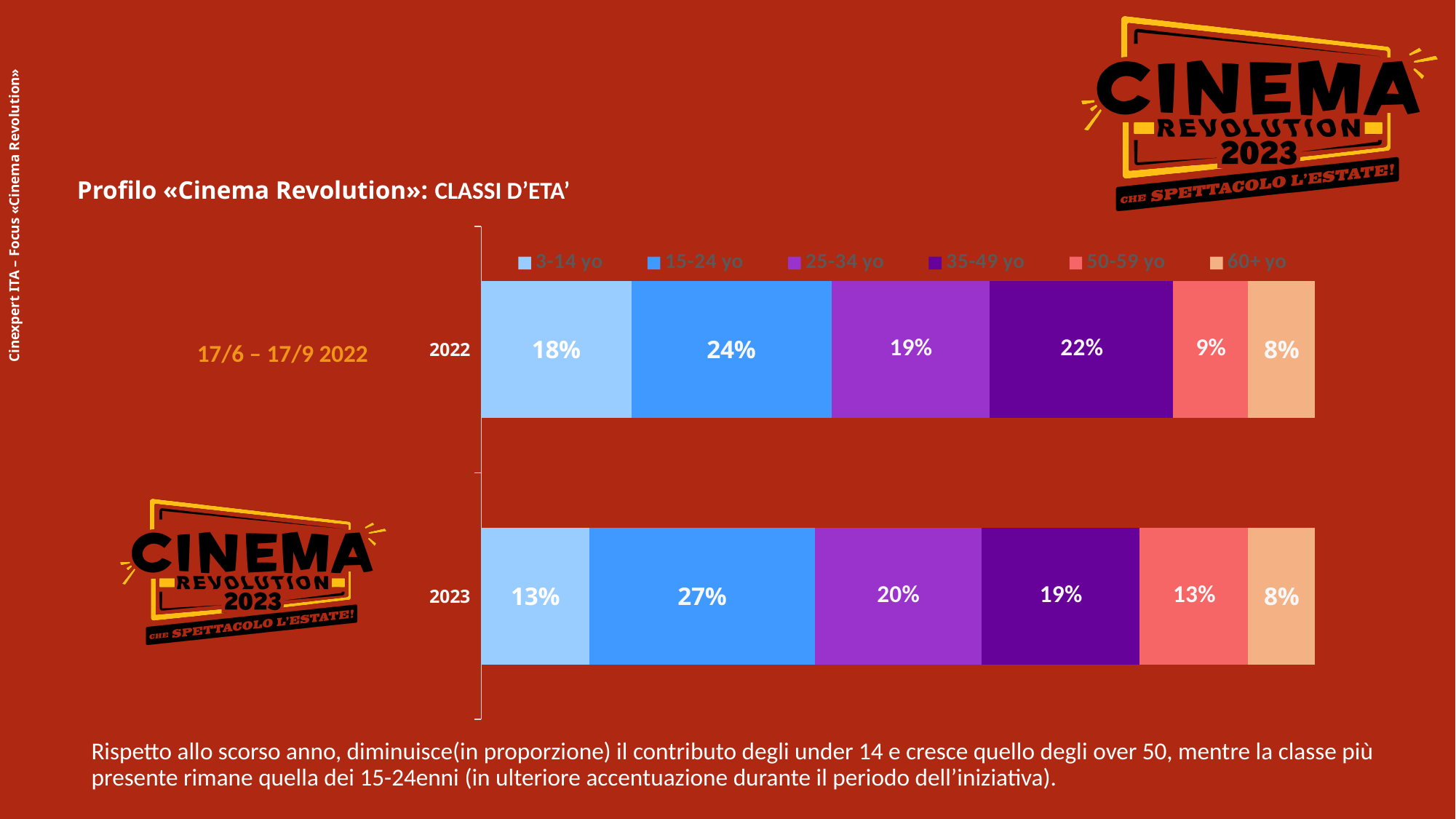
What is the total of the 2023 stacked bar? 100% Which age group has the largest share in 2023? 15-24 yo What is the share of the 50-59 yo group in 2023? 13% How many bars (years) are plotted in the chart? 2 By how many percentage points did the 3-14 yo share change from 2022 to 2023? 5 percentage points (18% to 13%) Which age group has the smallest share in 2022? 60+ yo What is the share of the 15-24 yo group in 2022? 24% How many series does the legend list? 6 Which legend entry is shown in the darkest purple colour? 35-49 yo What is the share of the 3-14 yo group in 2023? 13% What kind of chart is shown on the slide? Stacked bar chart Which is larger: the 35-49 yo share in 2022 or in 2023? 2022 (22%)